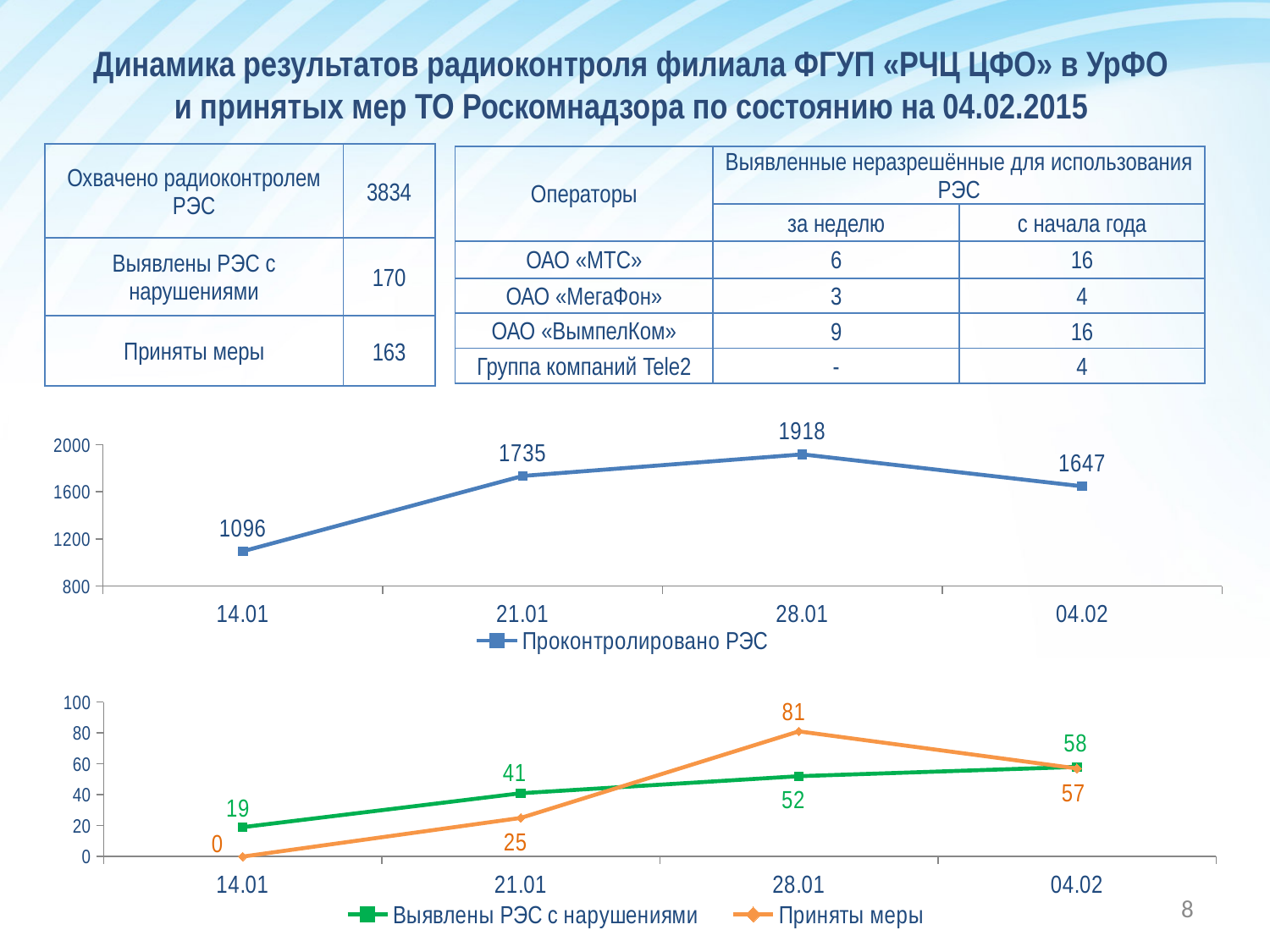
In the top chart (Проконтролировано РЭС), which date has the highest value? 28.01 In the top chart (Проконтролировано РЭС), which date has the lowest value? 14.01 In the top chart (Проконтролировано РЭС), what is the difference between the values for 21.01 and 04.02? 88 What type of chart is the top chart? line chart In the bottom chart, what is the value of Приняты меры for 28.01? 81 In the top chart (Проконтролировано РЭС), what is the value for 14.01? 1096 In the bottom chart, what is the value of Выявлены РЭС с нарушениями for 21.01? 41 In the bottom chart, how many series does the legend list? 2 In the bottom chart, which is larger for 28.01: Выявлены РЭС с нарушениями or Приняты меры? Приняты меры In the bottom chart, does the Выявлены РЭС с нарушениями series rise or fall from 14.01 to 04.02? rise In the top chart (Проконтролировано РЭС), what is the value for 28.01? 1918 In the top chart, how many data points are plotted? 4